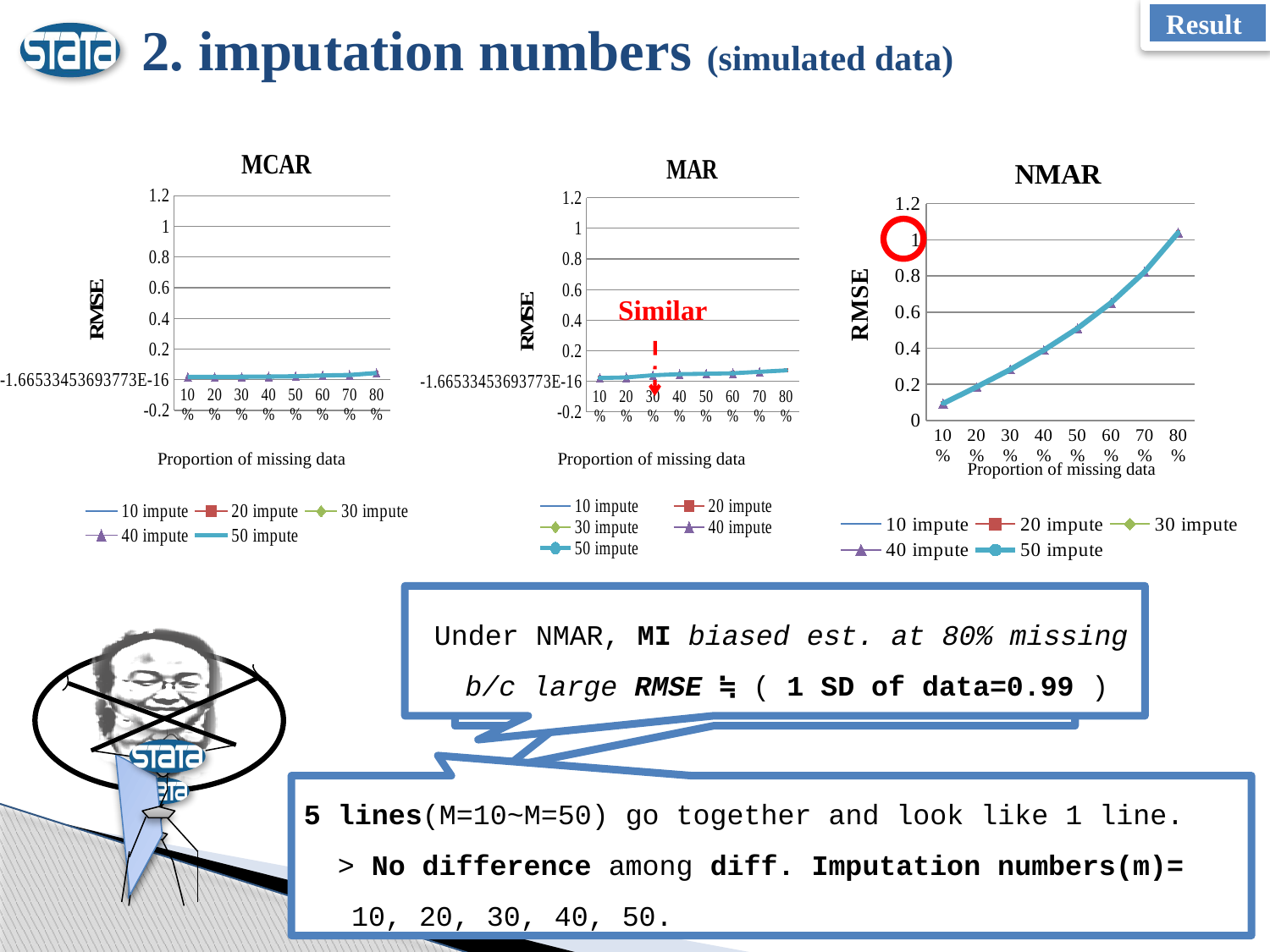
In the NMAR chart, do the RMSE values rise or fall as the proportion of missing data increases? rise What kind of chart is the NMAR chart? line chart In the NMAR chart, at which proportion of missing data is RMSE lowest? 10% In the NMAR chart, is the RMSE value at 80% missing data greater or less than 0.8? greater In the NMAR chart, is the RMSE value at 10% missing data greater or less than 0.2? less In the MCAR chart, is the RMSE value at 80% missing data greater or less than 0.2? less In the NMAR chart, which has the larger RMSE: 80% missing data or 20% missing data? 80% What is the x-axis label of the MCAR chart? Proportion of missing data In the NMAR chart, at which proportion of missing data is RMSE highest? 80% How many series does the legend of the MCAR chart list? 5 How many proportion-of-missing-data points are plotted along the x axis of the NMAR chart? 8 What is the y-axis label of the MAR chart? RMSE